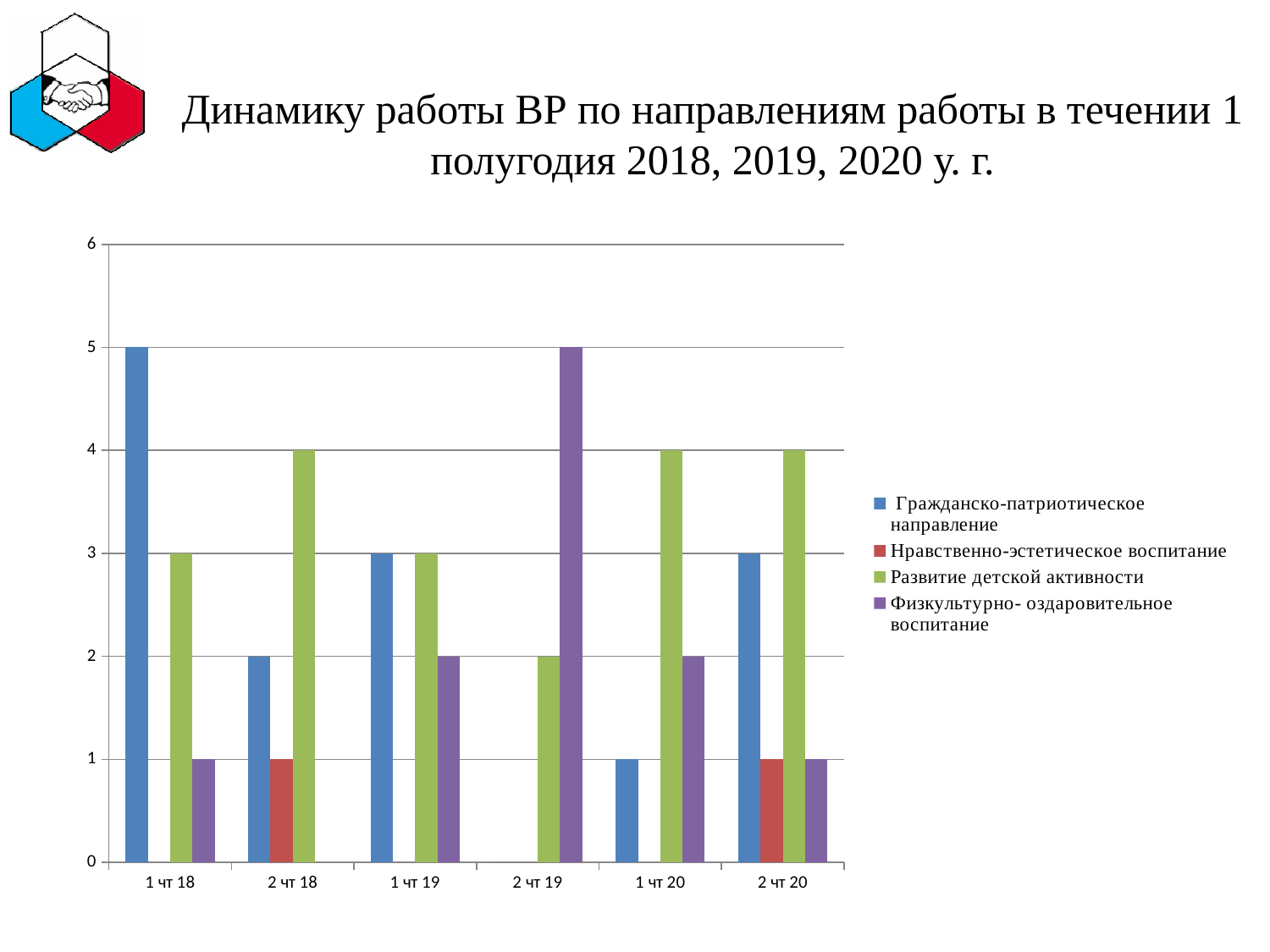
What type of chart is shown on the slide? bar chart What is the difference between Развитие детской активности and Гражданско-патриотическое направление in 1 чт 20? 3 Which colour represents Развитие детской активности in the legend? green How many series does the legend list? 4 Which is larger in 1 чт 19: Гражданско-патриотическое направление or Физкультурно- оздаровительное воспитание? Гражданско-патриотическое направление In which category is the value for Гражданско-патриотическое направление the highest? 1 чт 18 What is the value for Гражданско-патриотическое направление in 1 чт 18? 5 How many categories are shown on the x axis? 6 What is the value for Развитие детской активности in 2 чт 18? 4 What is the value for Нравственно-эстетическое воспитание in 2 чт 20? 1 In which category is the value for Гражданско-патриотическое направление the lowest? 2 чт 19 What is the value for Физкультурно- оздаровительное воспитание in 2 чт 19? 5